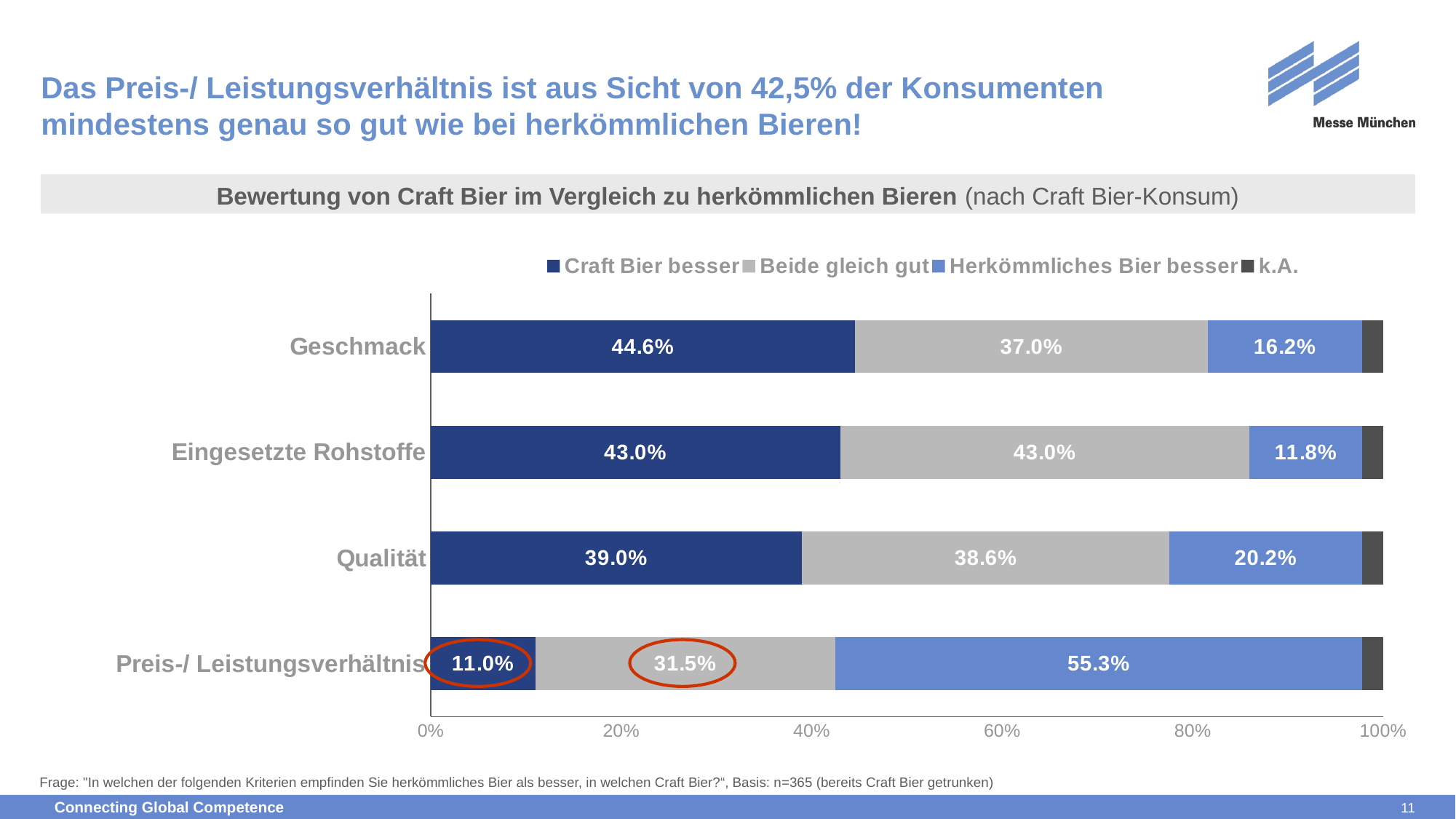
For which category is the Craft Bier besser value the highest? Geschmack In the Geschmack bar, which is larger: Craft Bier besser or Beide gleich gut? Craft Bier besser What share of respondents said conventional beer is better (Herkömmliches Bier besser) for Preis-/ Leistungsverhältnis? 55.3% What is the value for Beide gleich gut in the Eingesetzte Rohstoffe bar? 43.0% Is the k.A. segment for Geschmack greater or less than 20%? less In the Preis-/ Leistungsverhältnis bar, how many percentage points larger is Herkömmliches Bier besser than Craft Bier besser? 44.3 percentage points What percentage of respondents rated craft beer better (Craft Bier besser) for Geschmack? 44.6% What type of chart is shown on the slide? Stacked bar chart How many categories (criteria) are shown on the chart? 4 For which category is the Craft Bier besser value the lowest? Preis-/ Leistungsverhältnis How many series does the legend list? 4 What is the value for Herkömmliches Bier besser in the Qualität bar? 20.2%